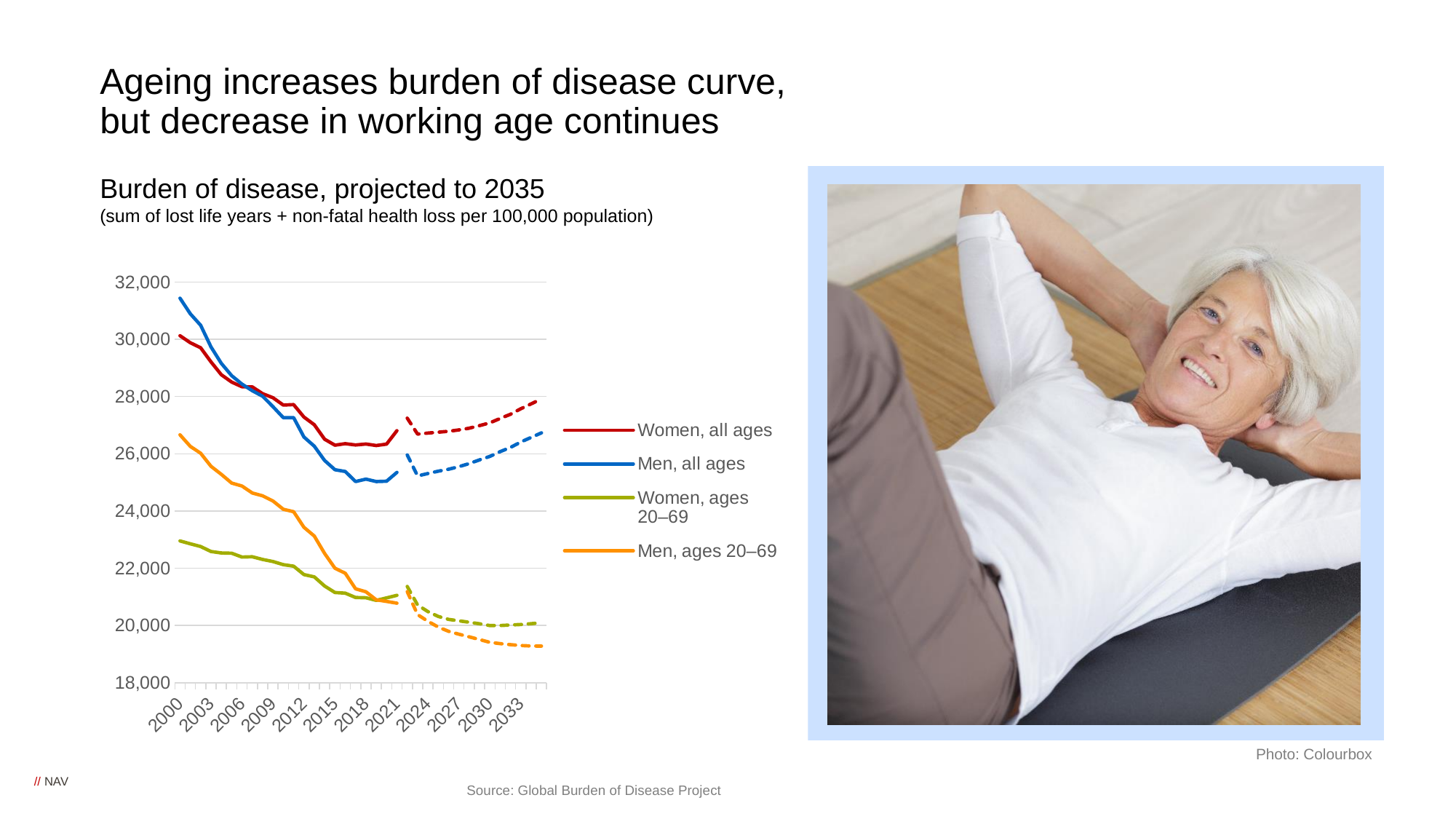
Is the value for Men, ages 20–69 in 2035 greater or less than 20,000? less What is the title of the chart? Burden of disease, projected to 2035 Is the value for Men, all ages in 2000 greater or less than 30,000? greater How many series does the chart's legend list? 4 What kind of chart is shown on the slide? Line chart In 2035, which is higher: Women, all ages or Men, all ages? Women, all ages In 2000, which is higher: Men, ages 20–69 or Women, ages 20–69? Men, ages 20–69 Which series has the highest value in 2000? Men, all ages Which series is plotted with a dashed orange line in the projection period? Men, ages 20–69 Which series has the lowest value in 2035? Men, ages 20–69 Does the value for Men, ages 20–69 rise or fall from 2000 to 2035? Fall Is the value for Women, ages 20–69 in 2000 greater or less than 24,000? less